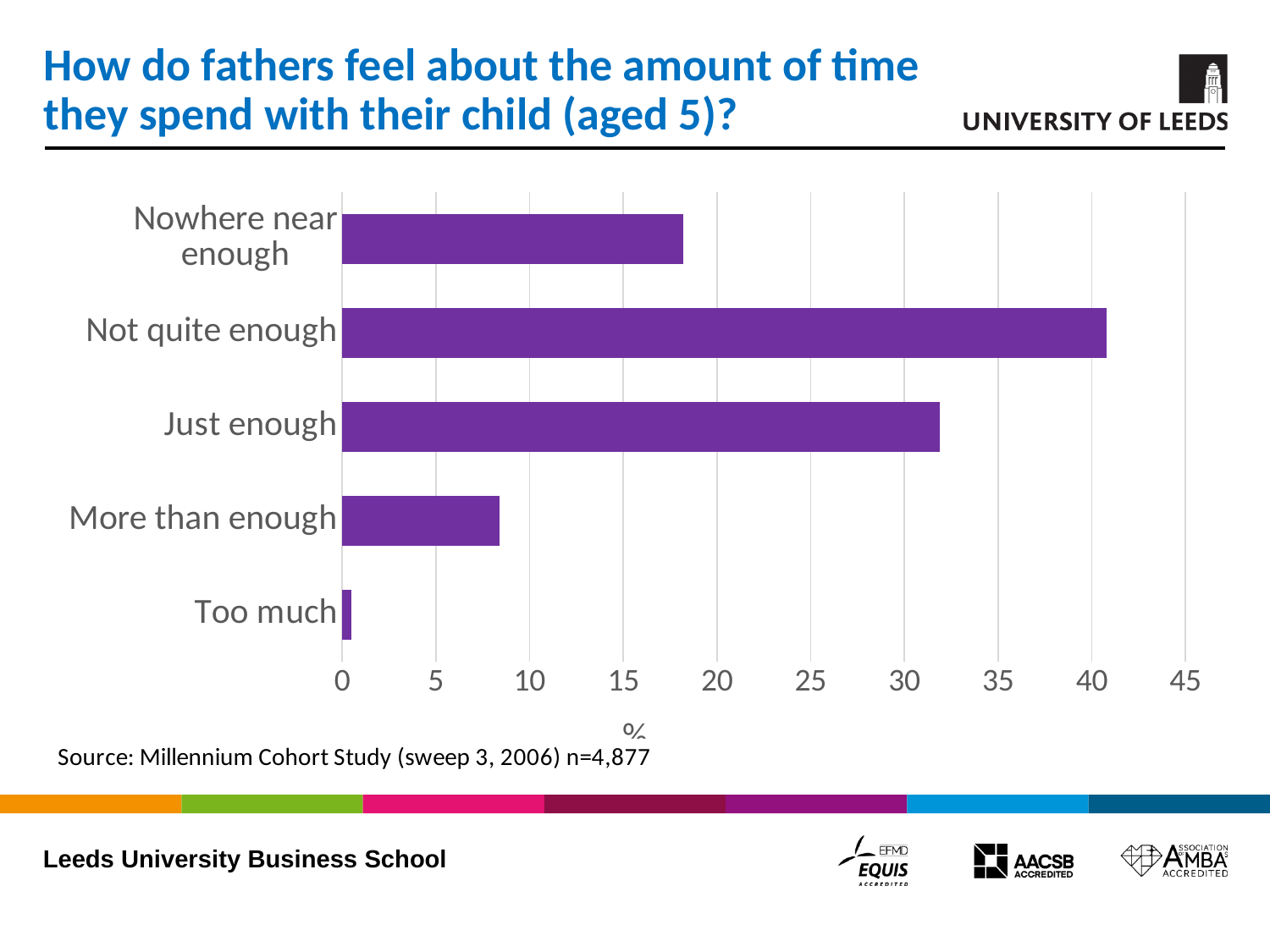
What is the source of the data shown in the chart? Millennium Cohort Study (sweep 3, 2006) n=4,877 Which is larger, the value for Just enough or the value for Nowhere near enough? Just enough Is the value for Not quite enough greater or less than 40? greater How many categories are shown on the chart? 5 Which category has the lowest value? Too much Is the value for More than enough greater or less than 10? less Is the value for Nowhere near enough greater or less than 20? less Which category has the highest value? Not quite enough What kind of chart is shown on the slide? bar chart What unit is shown on the horizontal axis? %